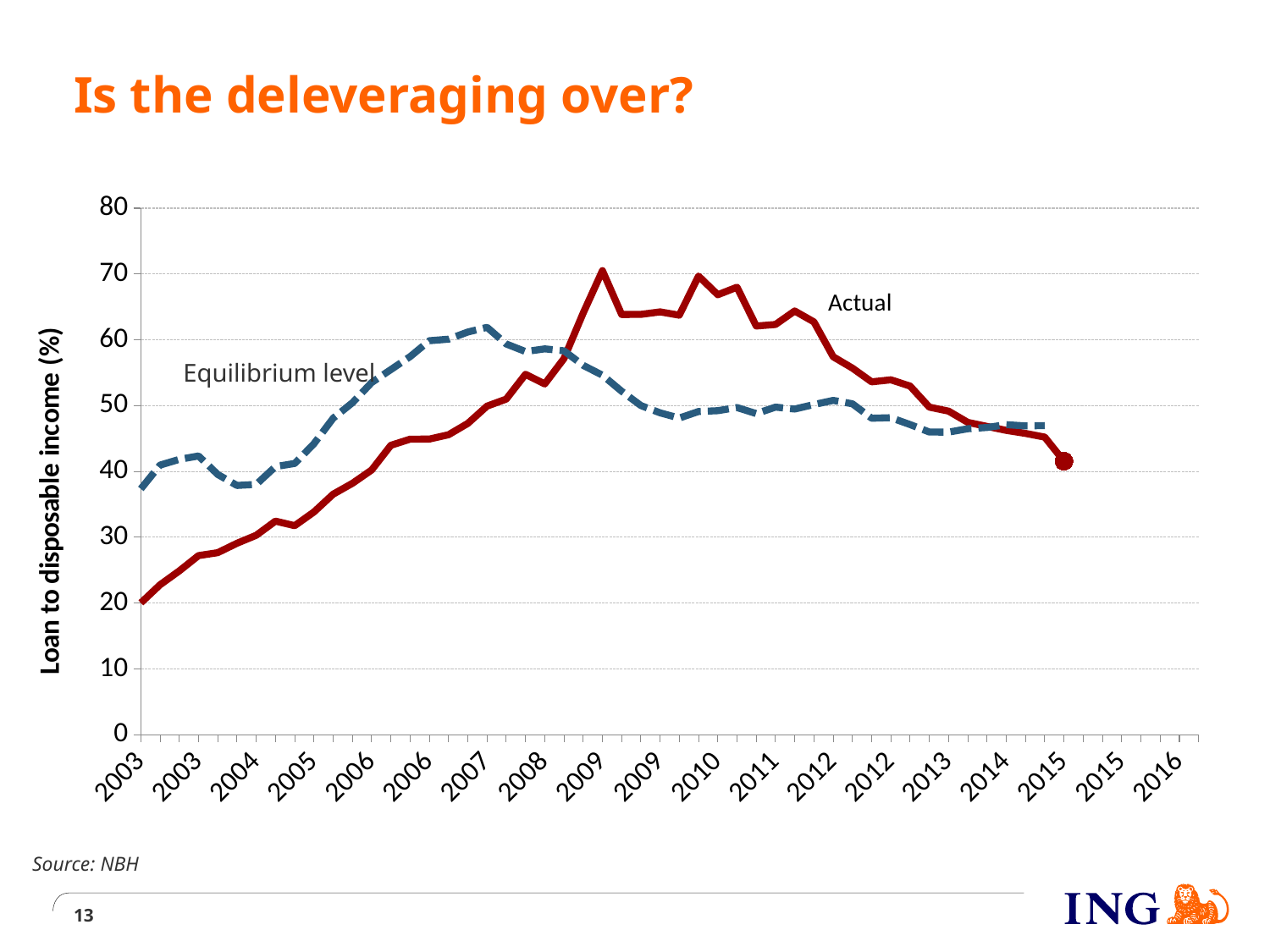
How many data series are plotted on the chart? 2 Is the final value of the Actual series in 2015 greater or less than 50? less Is the value of the Actual series at the start of 2003 greater or less than 30? less What kind of chart is shown on the slide? line chart Is the Equilibrium level in 2004 greater or less than 50? less What is the title of the vertical axis? Loan to disposable income (%) In 2010, which series is higher, Actual or Equilibrium level? Actual Does the Actual series rise or fall between 2010 and 2015? fall Does the Actual series rise or fall between 2003 and 2009? rise Which series is drawn as a dashed line? Equilibrium level